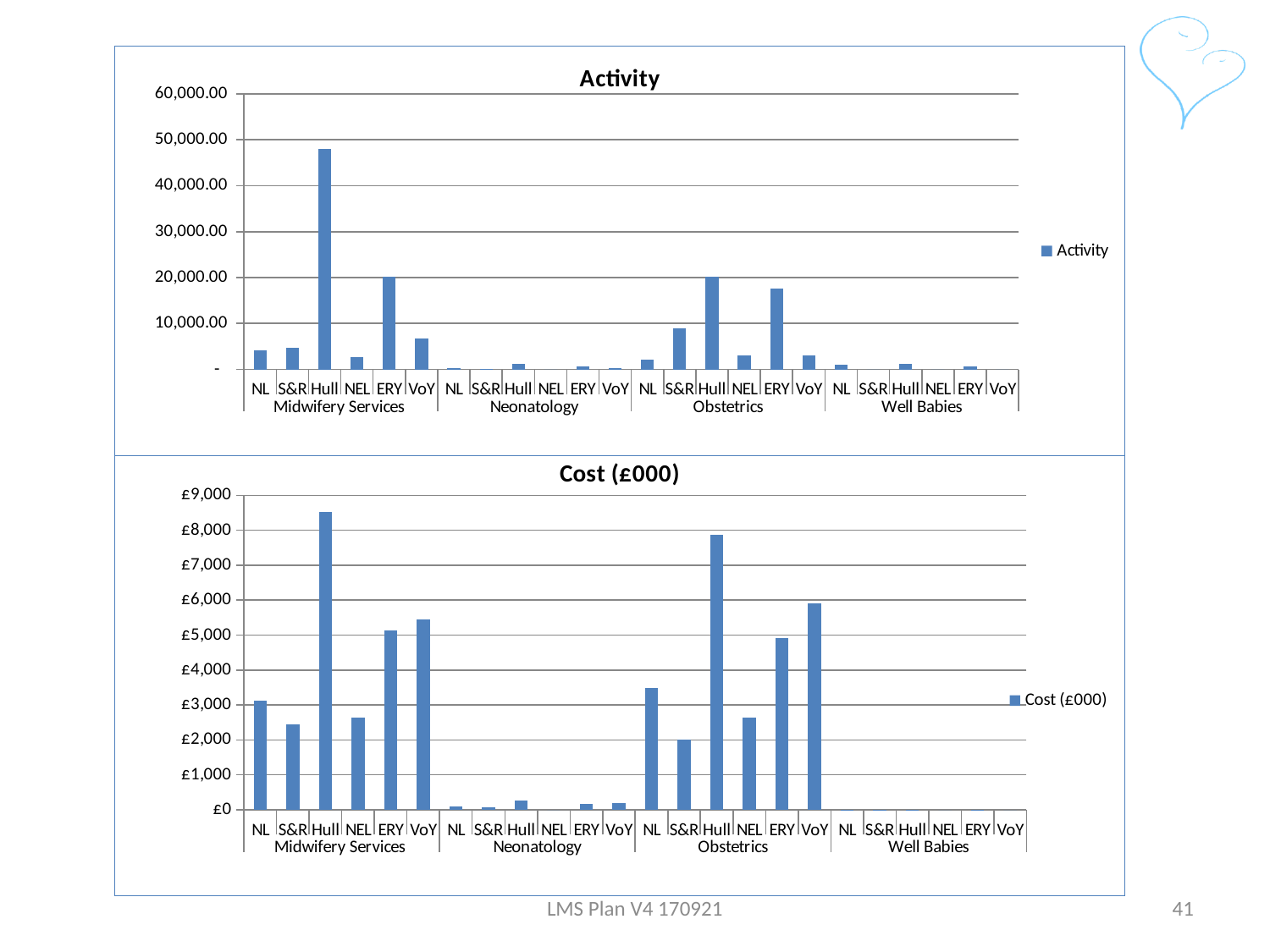
In the Activity chart, which is larger: Hull under Midwifery Services or Hull under Obstetrics? Hull under Midwifery Services In the Activity chart, which bar is the highest? Hull in Midwifery Services How many series does the legend of the Activity chart list? 1 In the Cost (£000) chart, is the value for Hull under Obstetrics greater or less than £7,000? greater How many service groups are shown along the x axis of the Activity chart? 4 In the Activity chart, is the value for ERY under Obstetrics greater or less than 20,000.00? less What kind of chart is the Activity chart? bar chart In the Cost (£000) chart, which bar is the highest? Hull in Midwifery Services What kind of chart is the Cost (£000) chart? bar chart In the Activity chart, is the value for Hull under Midwifery Services greater or less than 40,000.00? greater What is the legend entry shown on the Cost (£000) chart? Cost (£000) In the Cost (£000) chart, which is larger: NL under Obstetrics or S&R under Obstetrics? NL under Obstetrics